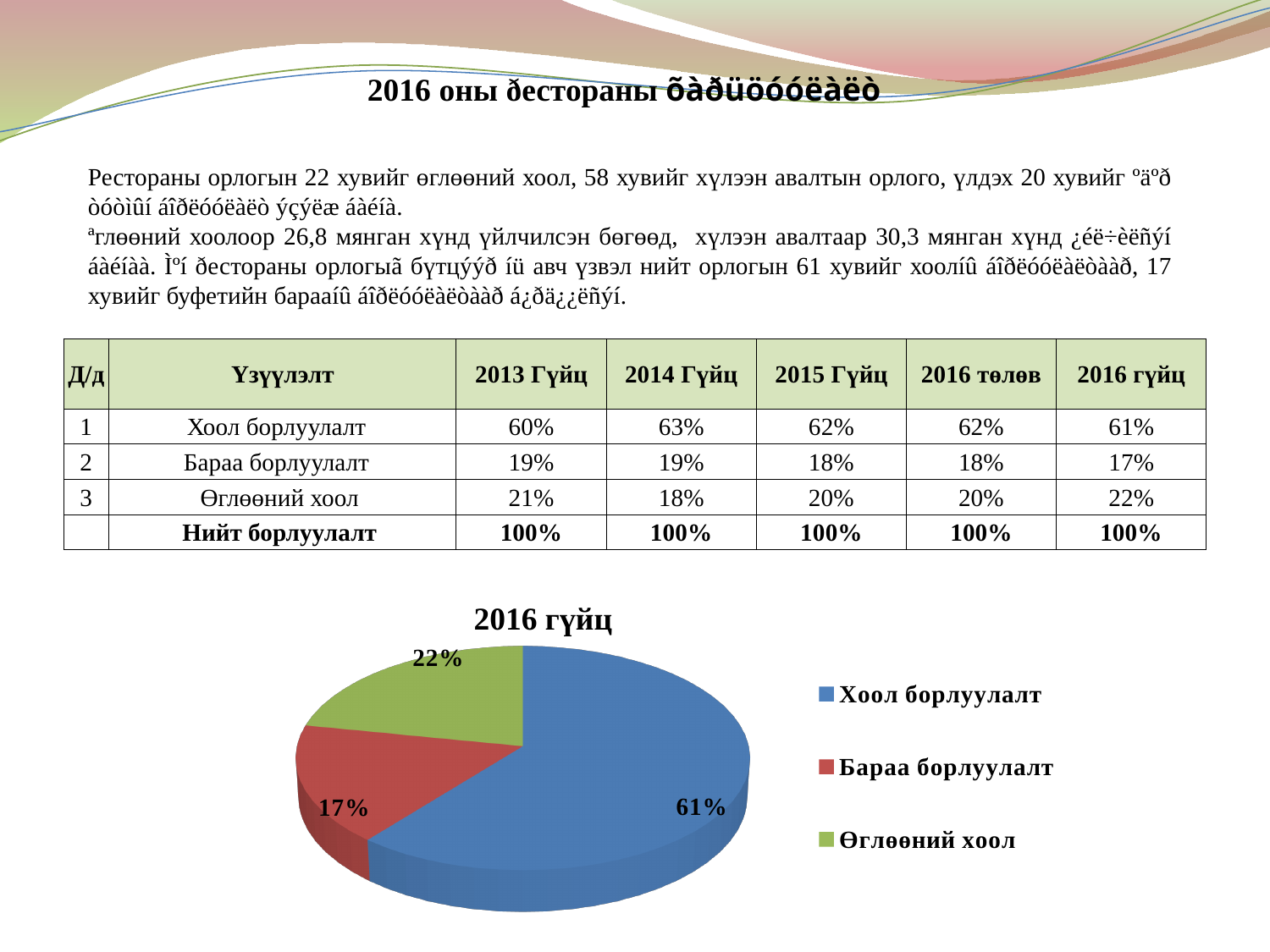
How many slices does the pie chart have? 3 Which is larger, the share of Өглөөний хоол or the share of Бараа борлуулалт? Өглөөний хоол Which category has the largest slice of the pie? Хоол борлуулалт Which category has the smallest slice of the pie? Бараа борлуулалт What share of the pie does Өглөөний хоол have? 22% What is the title of the chart? 2016 гүйц What is the difference between the shares of Хоол борлуулалт and Өглөөний хоол? 39% How many entries does the legend list? 3 What share of the pie does Хоол борлуулалт have? 61% What type of chart is shown on the slide? pie chart What colour is the slice for Өглөөний хоол? green What share of the pie does Бараа борлуулалт have? 17%